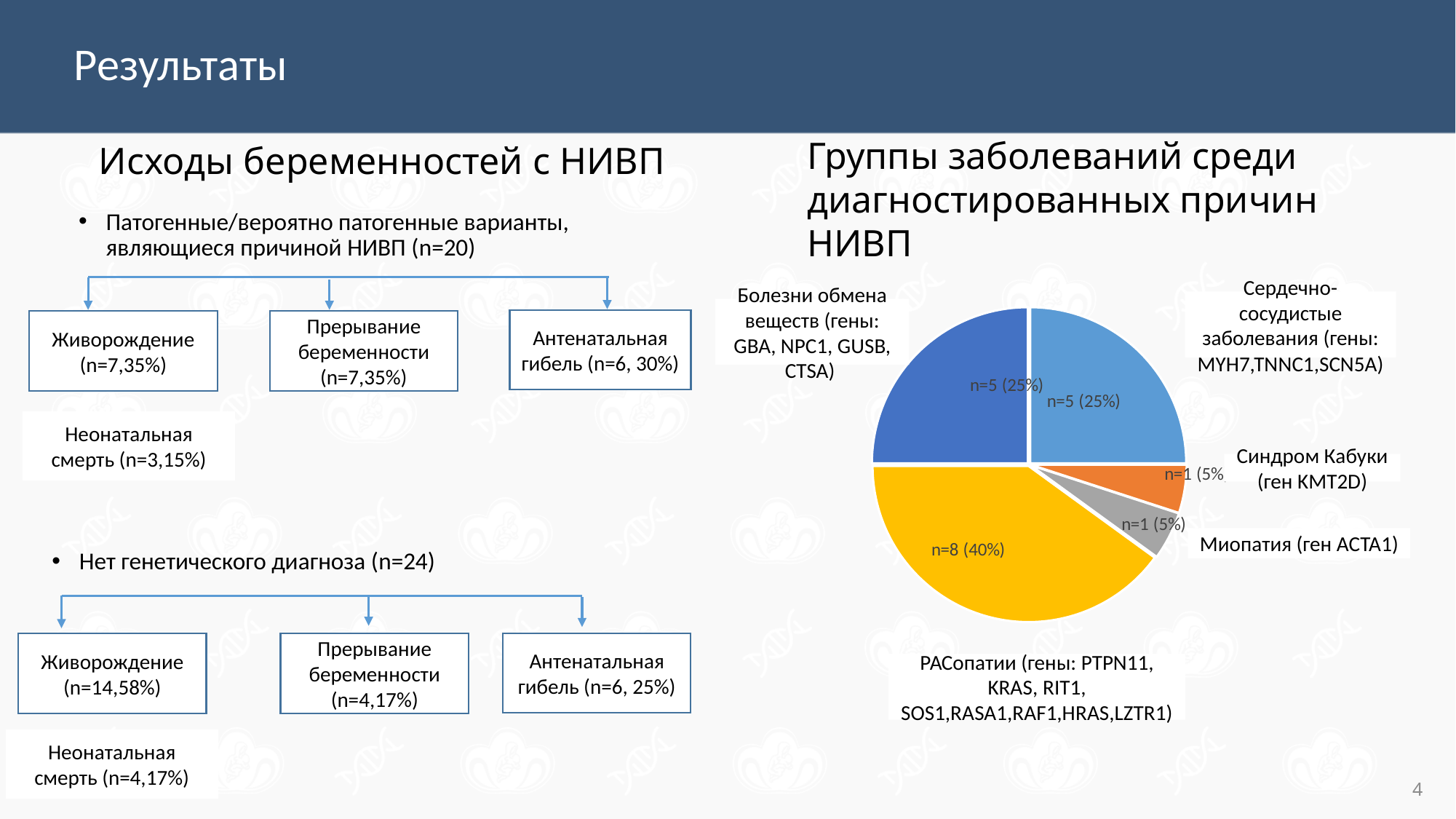
In the pie chart, what is the total number of cases across all slices? 20 In the pie chart, which disease group has the largest slice? РАСопатии In the pie chart, what share of the diagnosed causes is attributed to Болезни обмена веществ? 25% In the pie chart, how many more cases are in the РАСопатии group than in the Сердечно-сосудистые заболевания group? 3 How many slices does the pie chart 'Группы заболеваний среди диагностированных причин НИВП' have? 5 What kind of chart is shown on the right side of the slide under the title 'Группы заболеваний среди диагностированных причин НИВП'? pie chart In the pie chart, what is the data label for the Синдром Кабуки slice? n=1 (5%) In the pie chart, what share does Миопатия (ген ACTA1) represent? 5% In the pie chart, which slice is larger: РАСопатии or Болезни обмена веществ? РАСопатии In the pie chart, what is the data label for the РАСопатии slice? n=8 (40%) In the pie chart, how many cases (n) are in the Сердечно-сосудистые заболевания group? n=5 In the pie chart, which gene is listed for the Синдром Кабуки slice? KMT2D